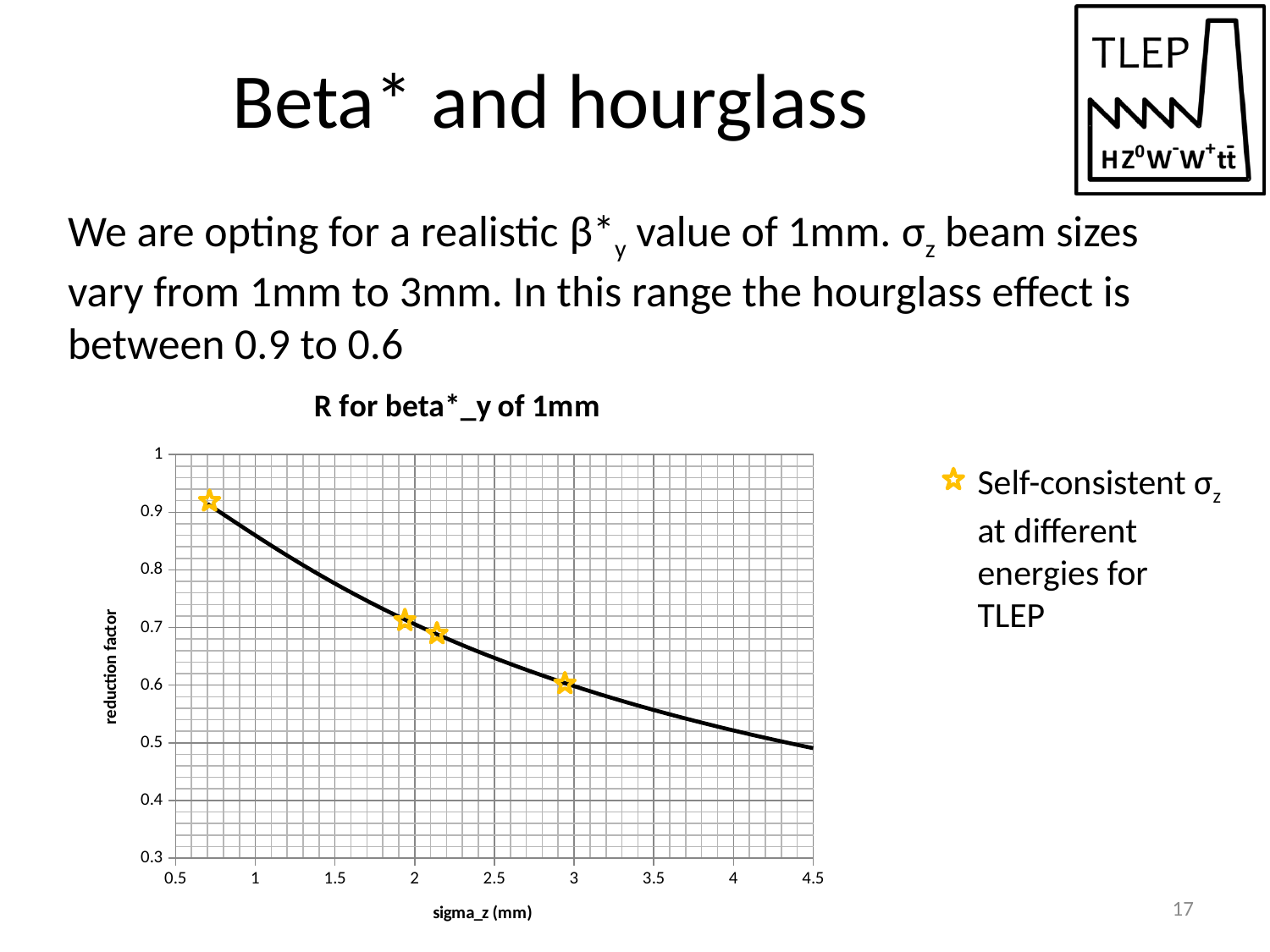
Is the reduction factor at sigma_z = 2 mm greater or less than 0.8? less Does the reduction factor rise or fall as sigma_z increases along the x axis? fall What kind of chart is shown on the slide? line chart Is the reduction factor at sigma_z = 1 mm greater or less than 0.8? greater Is the reduction factor higher at sigma_z = 1 mm or at sigma_z = 3 mm? 1 mm Is the reduction factor at sigma_z = 4 mm greater or less than 0.6? less What is the highest value shown on the y axis of the chart? 1 What is the label of the x axis of the chart? sigma_z (mm) What is the title of the chart? R for beta*_y of 1mm How many star markers are plotted on the curve? 4